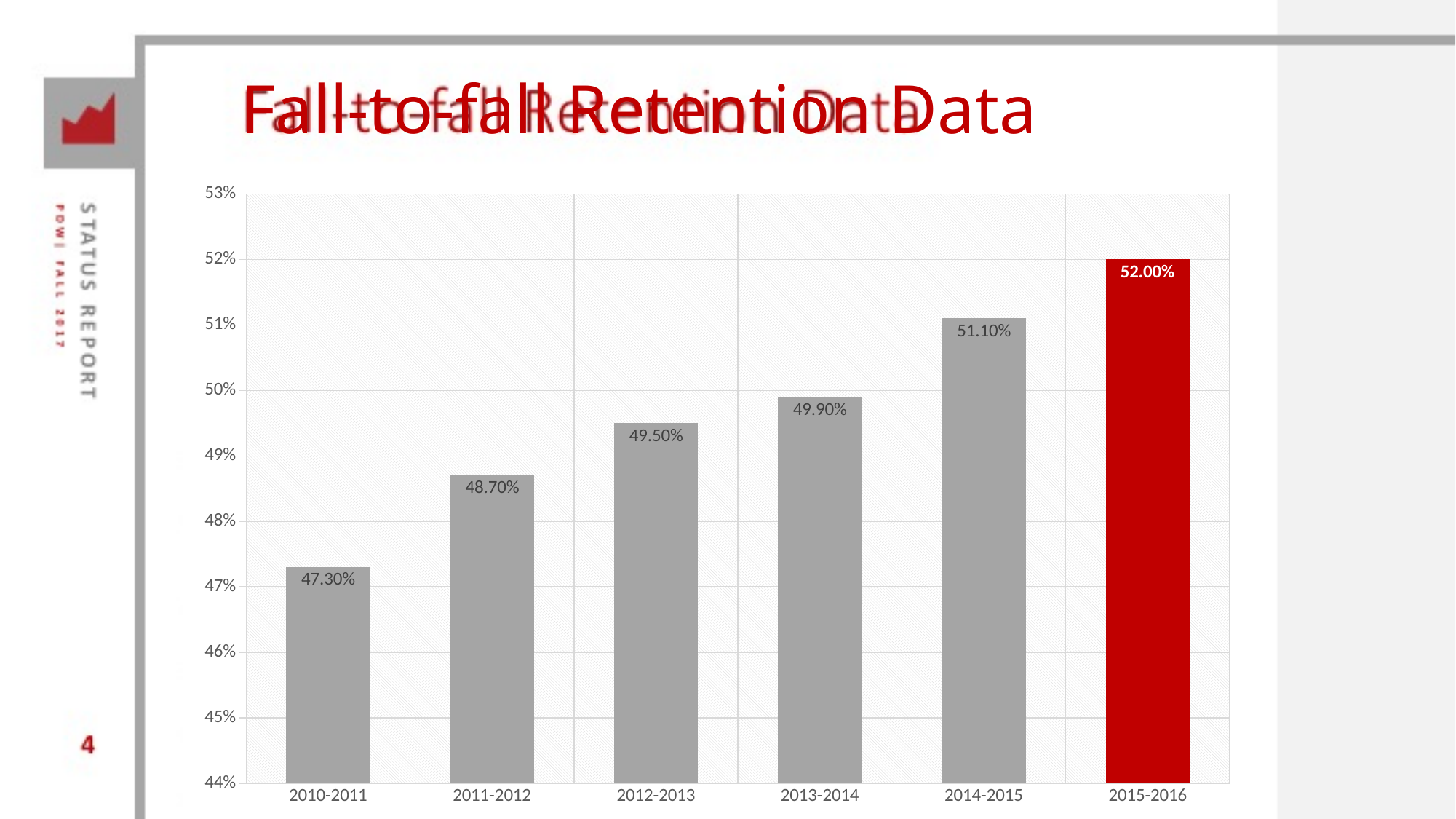
What is the retention value for 2013-2014? 49.90% What is the retention value for 2010-2011? 47.30% Do the retention values rise or fall from 2010-2011 to 2015-2016? rise What is the difference between the retention values for 2015-2016 and 2010-2011? 4.70% Which academic year has the highest retention value? 2015-2016 What is the retention value for 2015-2016? 52.00% Which is larger, the value for 2011-2012 or the value for 2012-2013? 2012-2013 Is the value for 2014-2015 greater or less than 50%? greater What kind of chart is shown on the slide? bar chart How many academic years are shown on the x axis? 6 Which academic year has the lowest retention value? 2010-2011 What is the difference between the retention values for 2014-2015 and 2013-2014? 1.20%